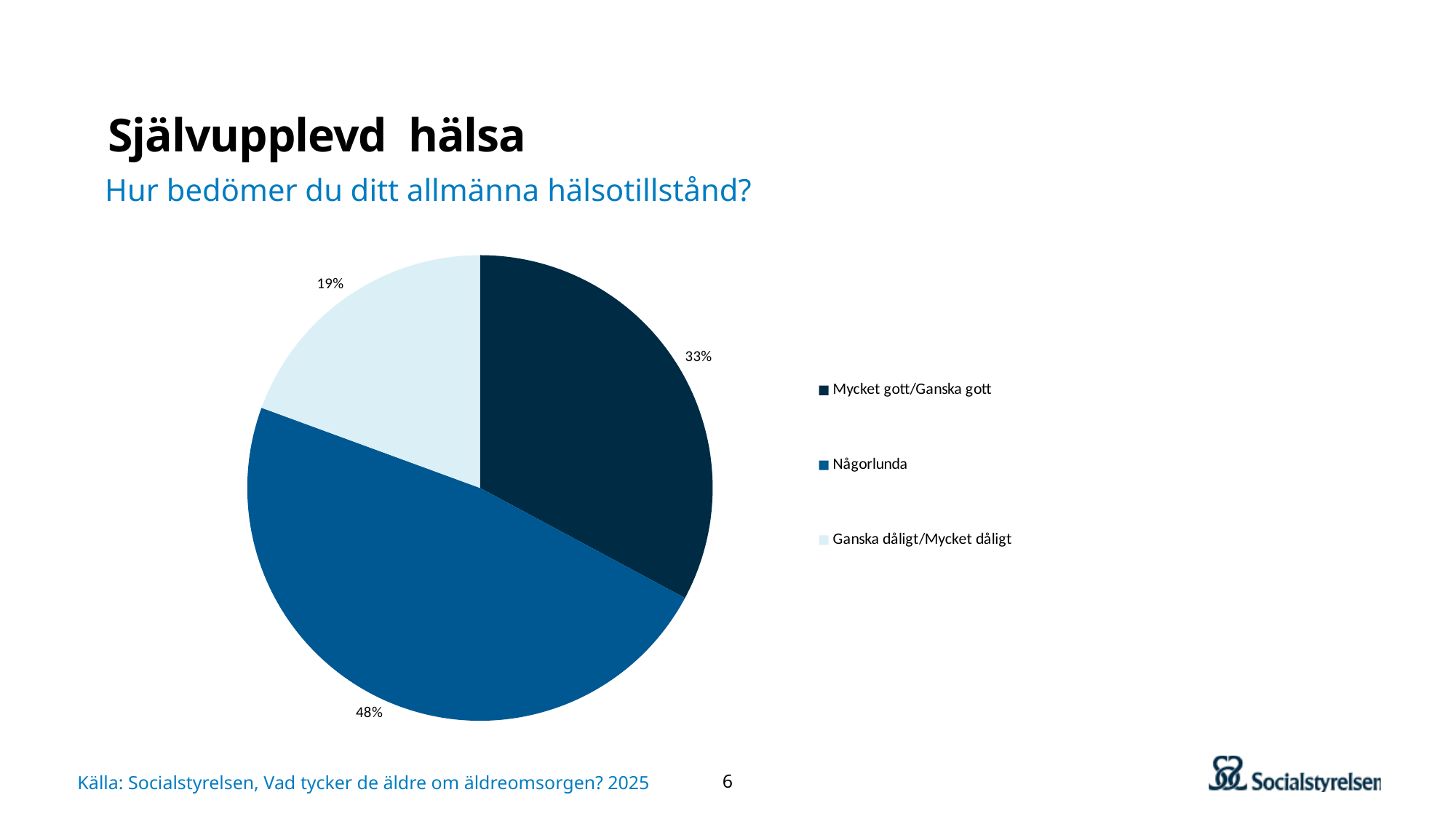
What share of the pie does Mycket gott/Ganska gott represent? 33% What share of the pie does Någorlunda represent? 48% Which category has the smallest slice of the pie? Ganska dåligt/Mycket dåligt How many slices does the pie chart have? 3 What is the difference in percentage points between Någorlunda and Mycket gott/Ganska gott? 15 Which is larger, the slice for Mycket gott/Ganska gott or the slice for Ganska dåligt/Mycket dåligt? Mycket gott/Ganska gott What is the difference in percentage points between Mycket gott/Ganska gott and Ganska dåligt/Mycket dåligt? 14 What kind of chart is shown on the slide? Pie chart Which category has the largest slice of the pie? Någorlunda What share of the pie does Ganska dåligt/Mycket dåligt represent? 19% How many entries does the legend list? 3 Which legend entry is shown in the lightest colour? Ganska dåligt/Mycket dåligt